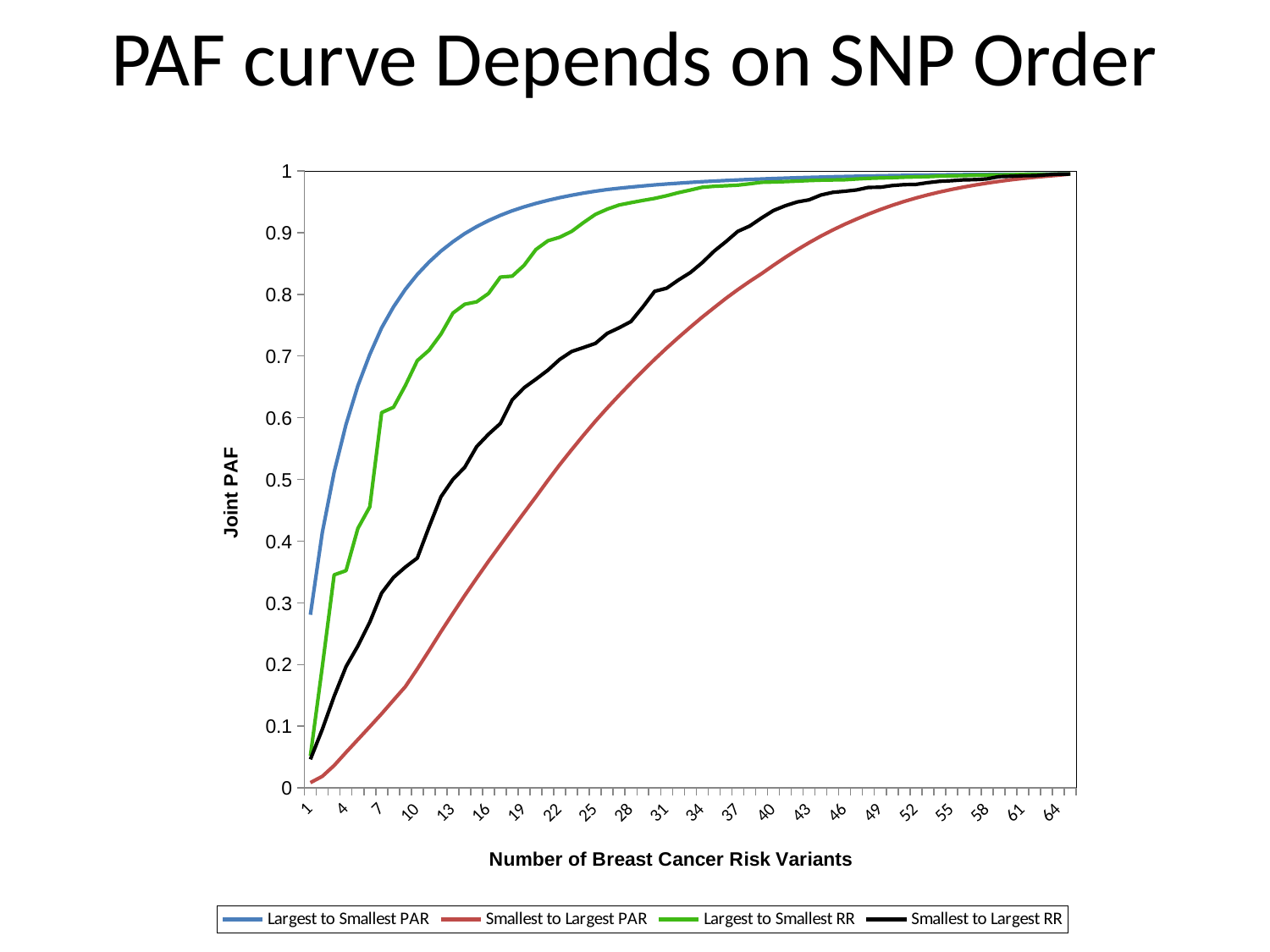
Is the value for Smallest to Largest PAR at 4 variants greater or less than 0.1? less At 19 variants, which series has the higher Joint PAF: Largest to Smallest RR or Smallest to Largest RR? Largest to Smallest RR How many series does the legend list? 4 Is the value for Smallest to Largest RR at 1 variant greater or less than 0.1? less What is the title of the x axis? Number of Breast Cancer Risk Variants Do the Joint PAF values rise or fall as the number of breast cancer risk variants increases? rise Is the value for Largest to Smallest RR at 7 variants greater or less than 0.5? greater What kind of chart is shown on the slide? line chart At 10 variants, which series has the higher Joint PAF: Largest to Smallest PAR or Smallest to Largest PAR? Largest to Smallest PAR What are the four series named in the legend? Largest to Smallest PAR, Smallest to Largest PAR, Largest to Smallest RR, Smallest to Largest RR Which series has the lowest Joint PAF at 10 variants? Smallest to Largest PAR